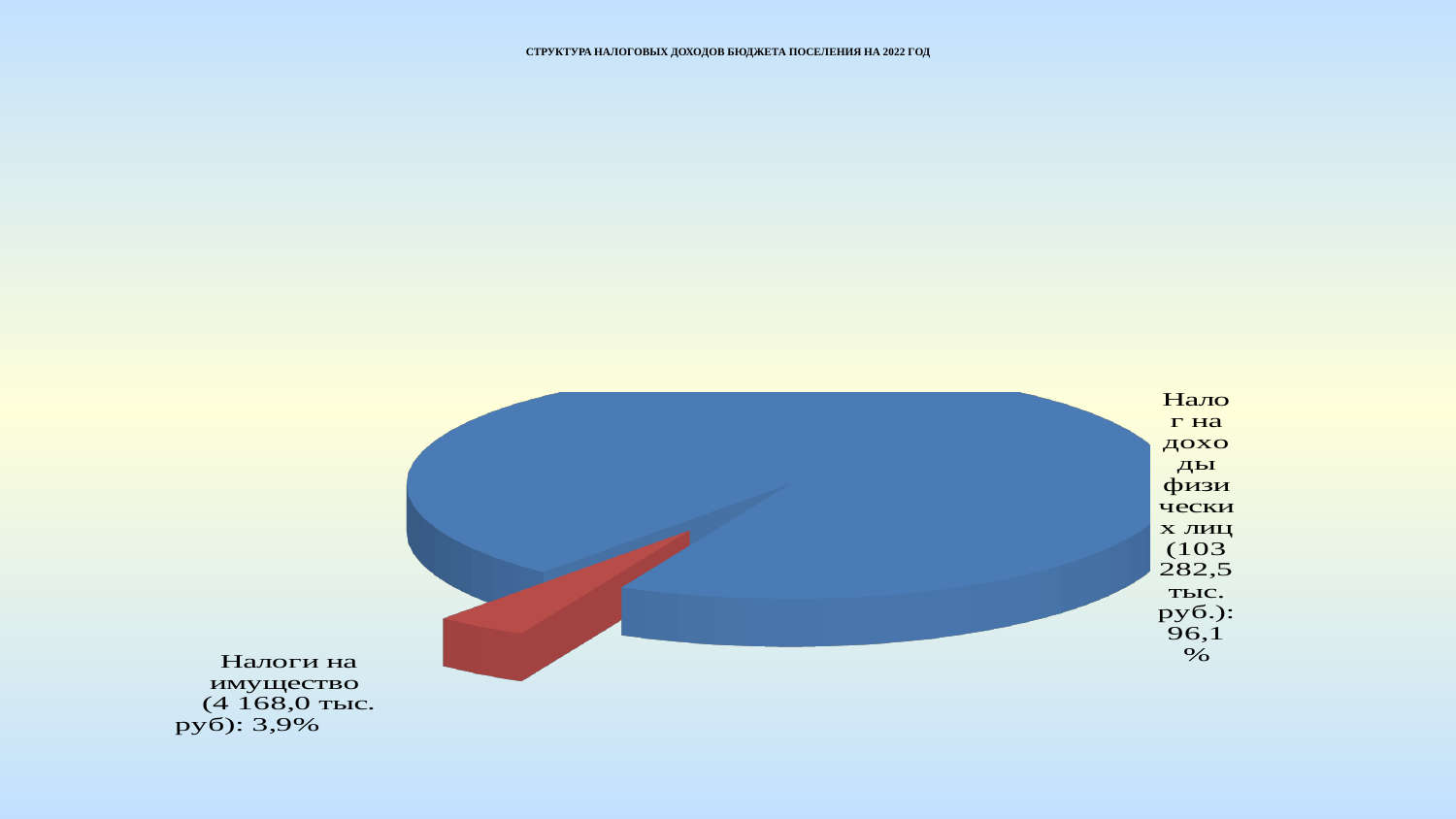
How many slices does the pie chart have? 2 What share of the pie does "Налог на доходы физических лиц" represent? 96,1% Which category has the smallest share of the pie? Налоги на имущество Which category has the largest share of the pie? Налог на доходы физических лиц What is the difference in percentage points between the share of "Налог на доходы физических лиц" and the share of "Налоги на имущество"? 92,2 What is the title of the chart? СТРУКТУРА НАЛОГОВЫХ ДОХОДОВ БЮДЖЕТА ПОСЕЛЕНИЯ НА 2022 ГОД What share of the pie does "Налоги на имущество" represent? 3,9% What amount in thousand rubles is shown for "Налог на доходы физических лиц"? 103 282,5 тыс. руб. What amount in thousand rubles is shown for "Налоги на имущество"? 4 168,0 тыс. руб What kind of chart is shown on the slide? Pie chart Which is larger: the share for "Налог на доходы физических лиц" or the share for "Налоги на имущество"? Налог на доходы физических лиц What colour is the slice for "Налоги на имущество"? Red